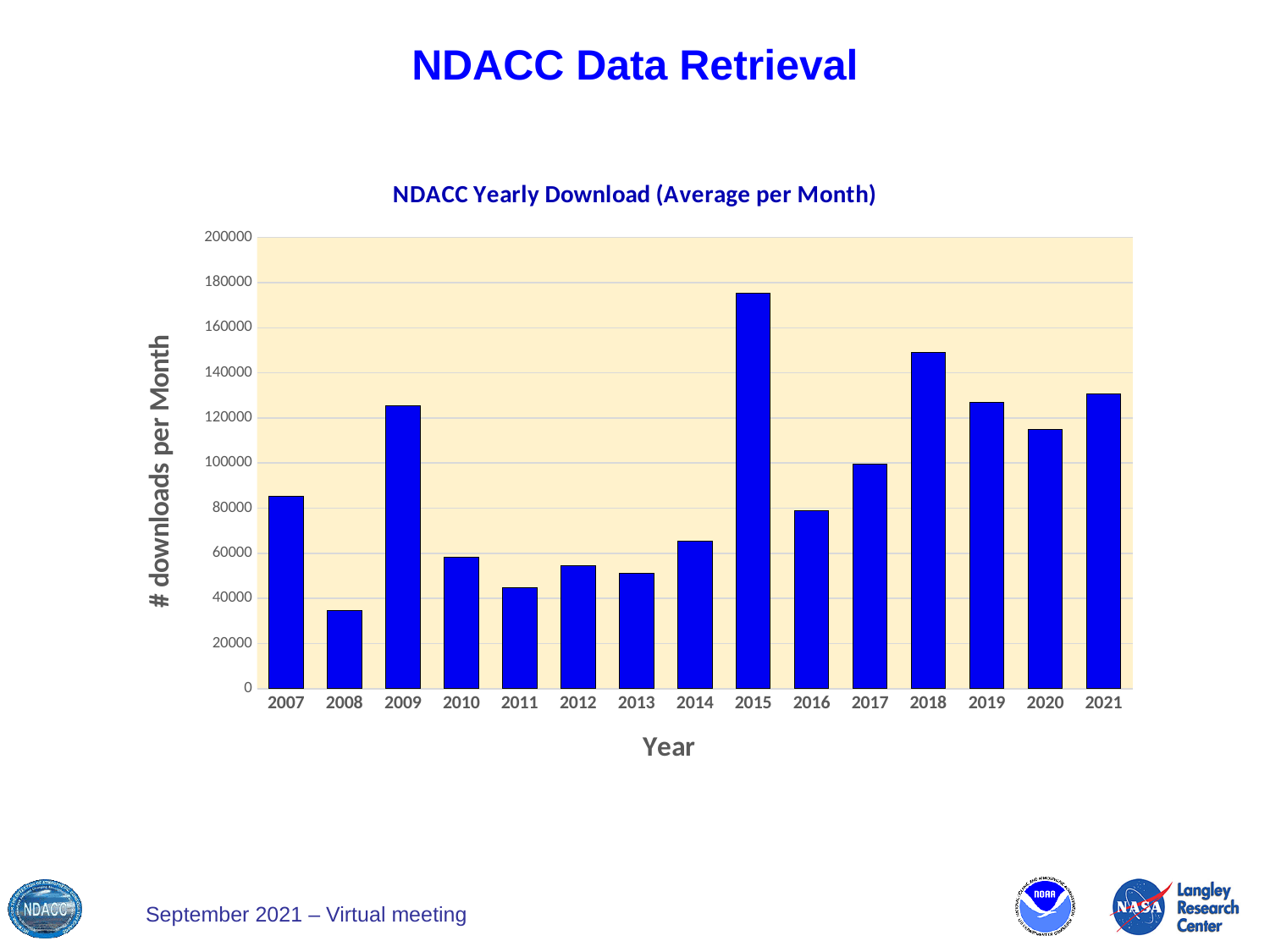
Which year has the larger value, 2009 or 2007? 2009 What is the title of the chart? NDACC Yearly Download (Average per Month) How many years are shown on the x axis of the chart? 15 Which year has the highest average downloads per month? 2015 Which year has the lowest average downloads per month? 2008 Do the values rise or fall from 2009 to 2011? fall Is the value for 2018 greater or less than 140000? greater Is the value for 2020 greater or less than 100000? greater What kind of chart is shown on the slide? bar chart Which year has the larger value, 2018 or 2019? 2018 Is the value for 2008 greater or less than 40000? less